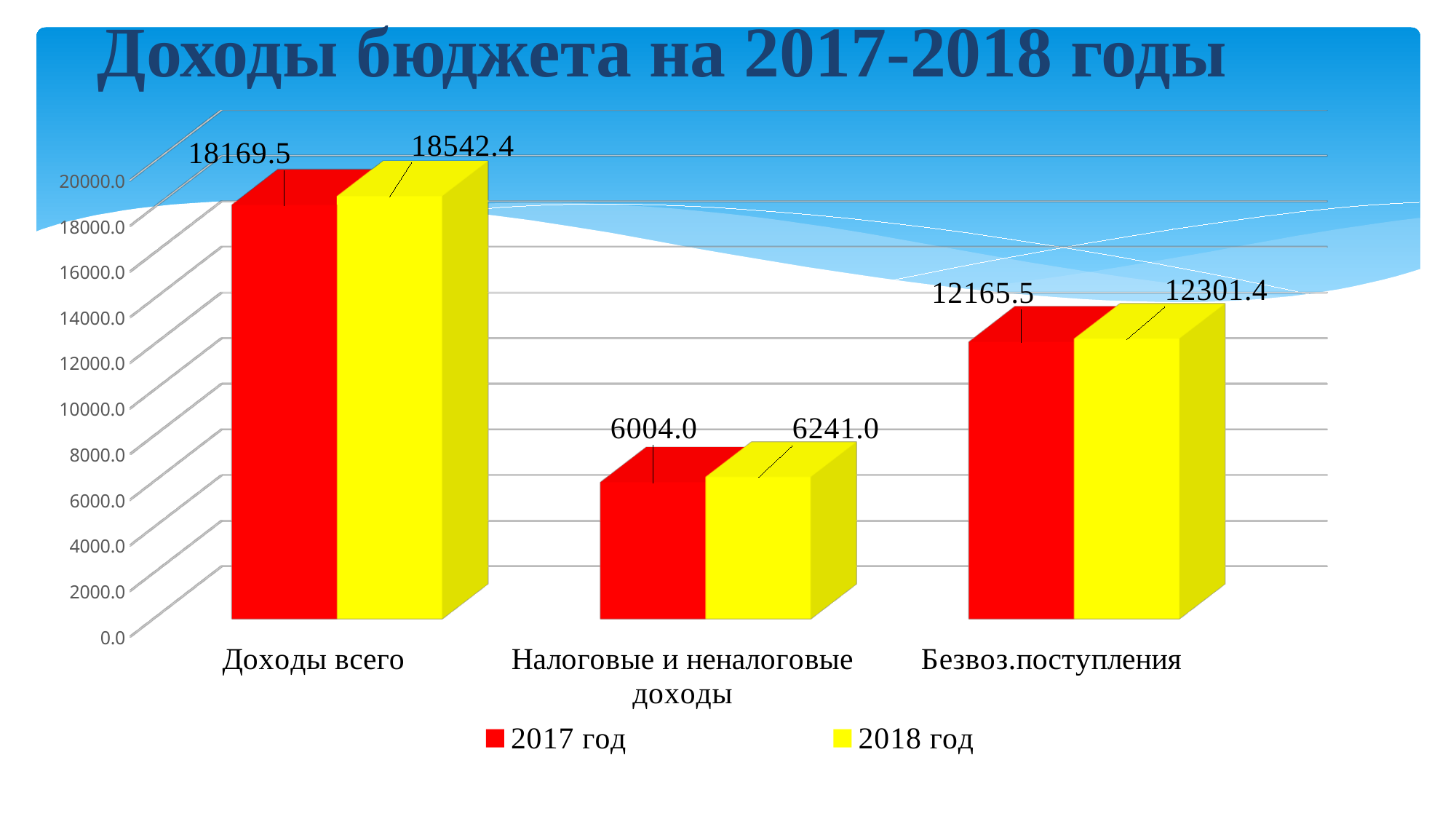
What is the difference between the 2018 год and 2017 год values for Налоговые и неналоговые доходы? 237.0 What is the value for Налоговые и неналоговые доходы in the 2017 год series? 6004.0 Which is larger for Безвоз.поступления: the 2017 год value or the 2018 год value? 2018 год Which category has the lowest value in the 2018 год series? Налоговые и неналоговые доходы What is the value for Безвоз.поступления in the 2018 год series? 12301.4 What is the value for Доходы всего in the 2018 год series? 18542.4 What is the value for Доходы всего in the 2017 год series? 18169.5 How many categories are shown on the x axis? 3 How many series does the legend list? 2 Which category has the highest value in the 2017 год series? Доходы всего What kind of chart is shown on the slide? Bar chart What is the difference between the 2018 год and 2017 год values for Доходы всего? 372.9